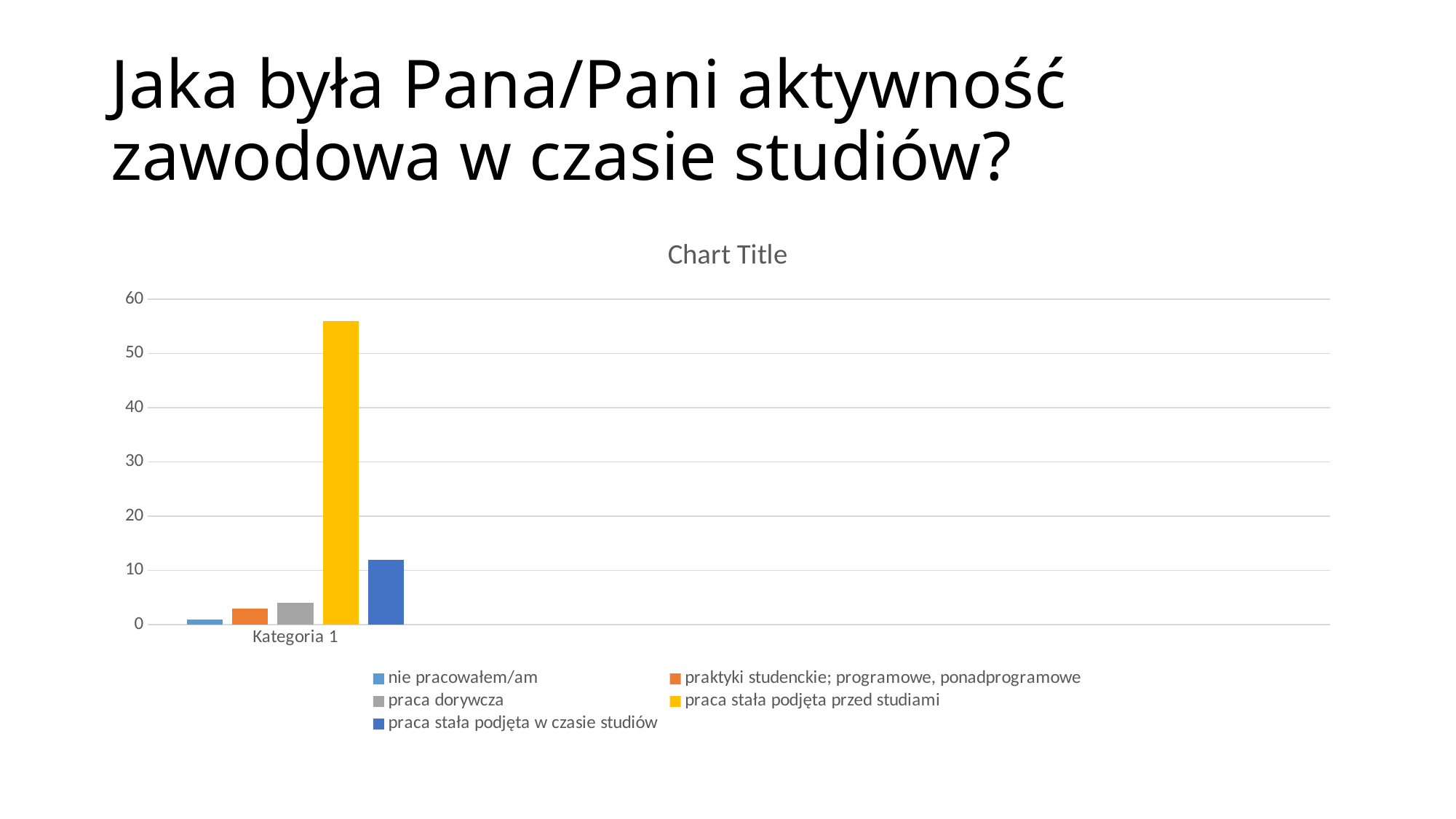
Which is larger: the value for 'praca dorywcza' or 'nie pracowałem/am'? praca dorywcza What is the title shown above the chart? Chart Title Which series has the highest bar? praca stała podjęta przed studiami Is the value for 'nie pracowałem/am' greater or less than 10? less Which is larger: the value for 'praca stała podjęta przed studiami' or 'praca stała podjęta w czasie studiów'? praca stała podjęta przed studiami Is the value for 'praca stała podjęta w czasie studiów' greater or less than 10? greater How many series does the legend list? 5 What kind of chart is shown on the slide? bar chart Is the value for 'praca stała podjęta przed studiami' greater or less than 50? greater How many categories are shown on the x axis? 1 Which series has the lowest bar? nie pracowałem/am